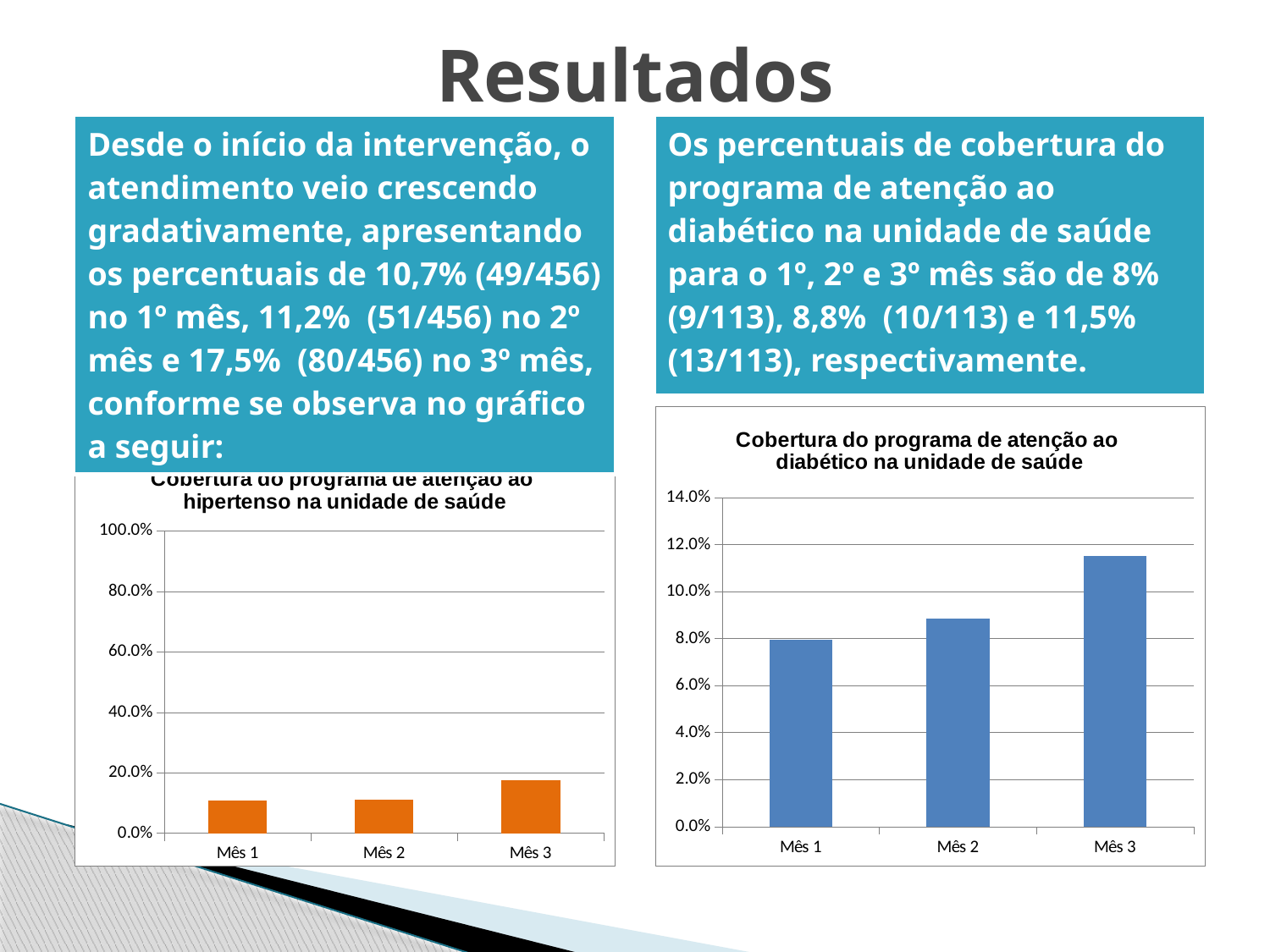
How many bars are shown in the chart titled "Cobertura do programa de atenção ao diabético na unidade de saúde"? 3 In the chart titled "Cobertura do programa de atenção ao diabético na unidade de saúde", is the value for Mês 3 greater or less than 10.0%? greater In the chart titled "Cobertura do programa de atenção ao hipertenso na unidade de saúde", which month has the highest bar? Mês 3 In the chart titled "Cobertura do programa de atenção ao diabético na unidade de saúde", which month has the highest bar? Mês 3 In the chart titled "Cobertura do programa de atenção ao diabético na unidade de saúde", is the value for Mês 2 greater or less than 8.0%? greater In the chart titled "Cobertura do programa de atenção ao diabético na unidade de saúde", which month has the lowest bar? Mês 1 What is the highest value shown on the y axis of the chart titled "Cobertura do programa de atenção ao hipertenso na unidade de saúde"? 100.0% What type of chart is the chart titled "Cobertura do programa de atenção ao hipertenso na unidade de saúde"? bar chart In the chart titled "Cobertura do programa de atenção ao diabético na unidade de saúde", is the value for Mês 3 greater or less than 12.0%? less In the chart titled "Cobertura do programa de atenção ao diabético na unidade de saúde", which is larger, the value for Mês 3 or the value for Mês 2? Mês 3 In the chart titled "Cobertura do programa de atenção ao diabético na unidade de saúde", do the values rise or fall from Mês 1 to Mês 3? rise